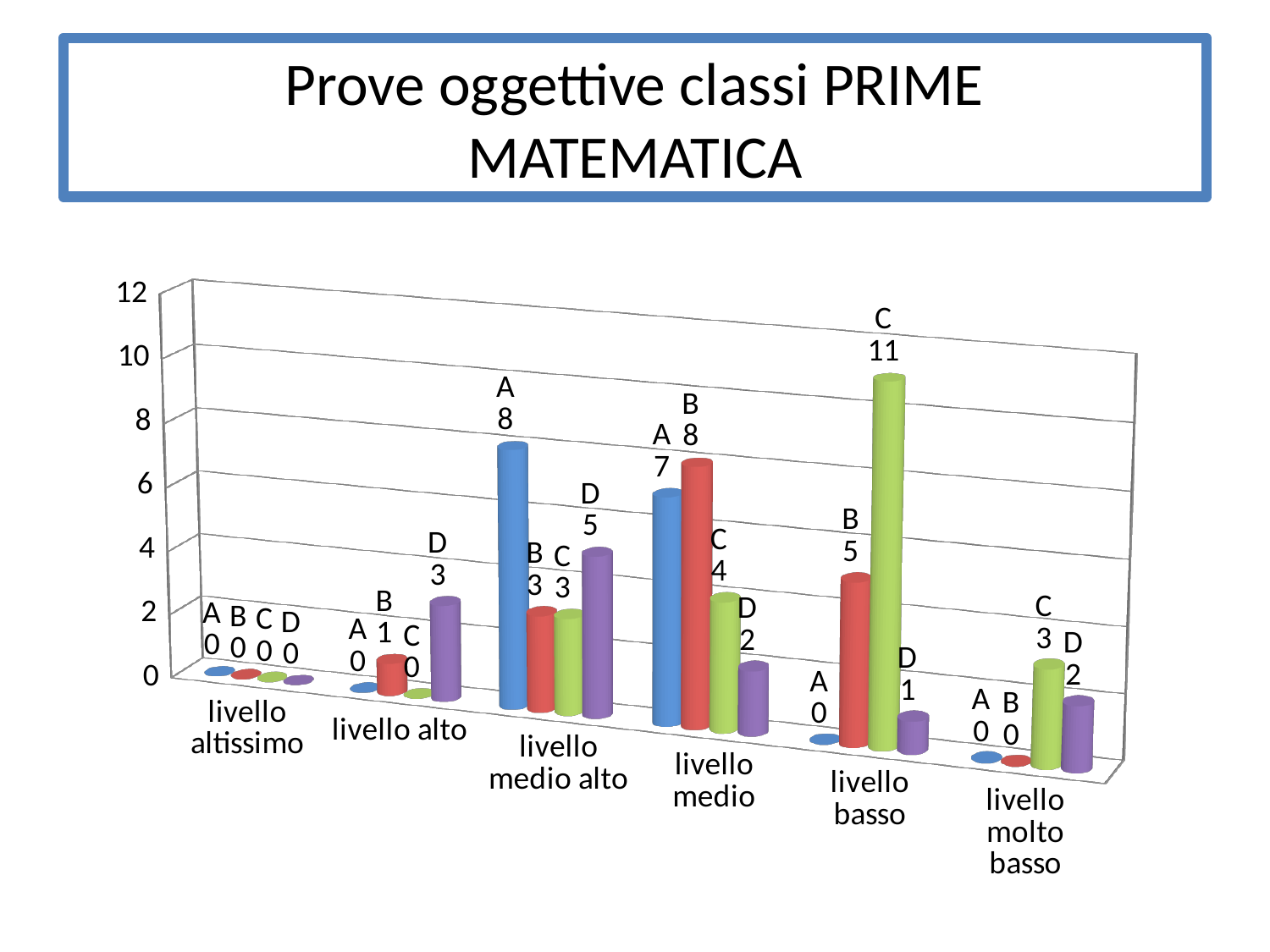
Which series has the highest value at livello medio alto? A Which is larger at livello medio: the value for series A or the value for series C? A What is the value for series D at livello alto? 3 What is the title of the slide? Prove oggettive classi PRIME MATEMATICA What is the value for series C at livello basso? 11 What is the value for series B at livello medio? 8 Which series has the highest value at livello basso? C What is the value for series A at livello medio alto? 8 How many categories are shown on the x axis? 6 What kind of chart is shown on the slide? bar chart What is the difference between the values for series A and series B at livello medio alto? 5 What is the difference between the values for series C and series D at livello basso? 10